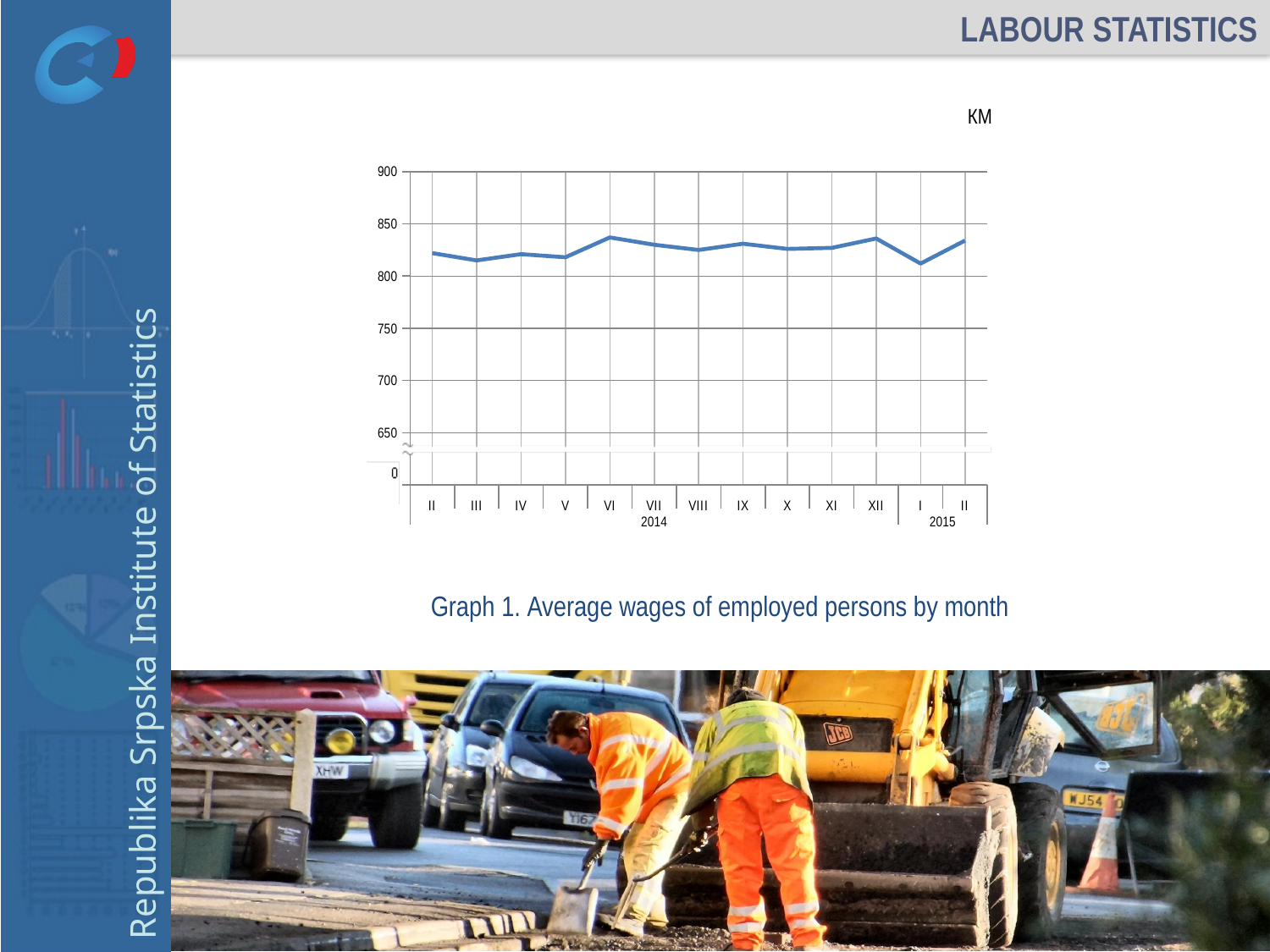
How many monthly data points are plotted on the line? 13 Is the value for VI 2014 greater or less than 800? greater Is the value for I 2015 greater or less than 800? greater Which is larger, the value for VI 2014 or the value for III 2014? VI 2014 What is the title of the chart on the slide? Graph 1. Average wages of employed persons by month Is the value for XII 2014 greater or less than 850? less What unit is shown above the chart for the plotted values? KM What kind of chart is Graph 1? line chart Does the line rise or fall from XII 2014 to I 2015? fall Which is larger, the value for I 2015 or the value for II 2015? II 2015 Does the line rise or fall from I 2015 to II 2015? rise